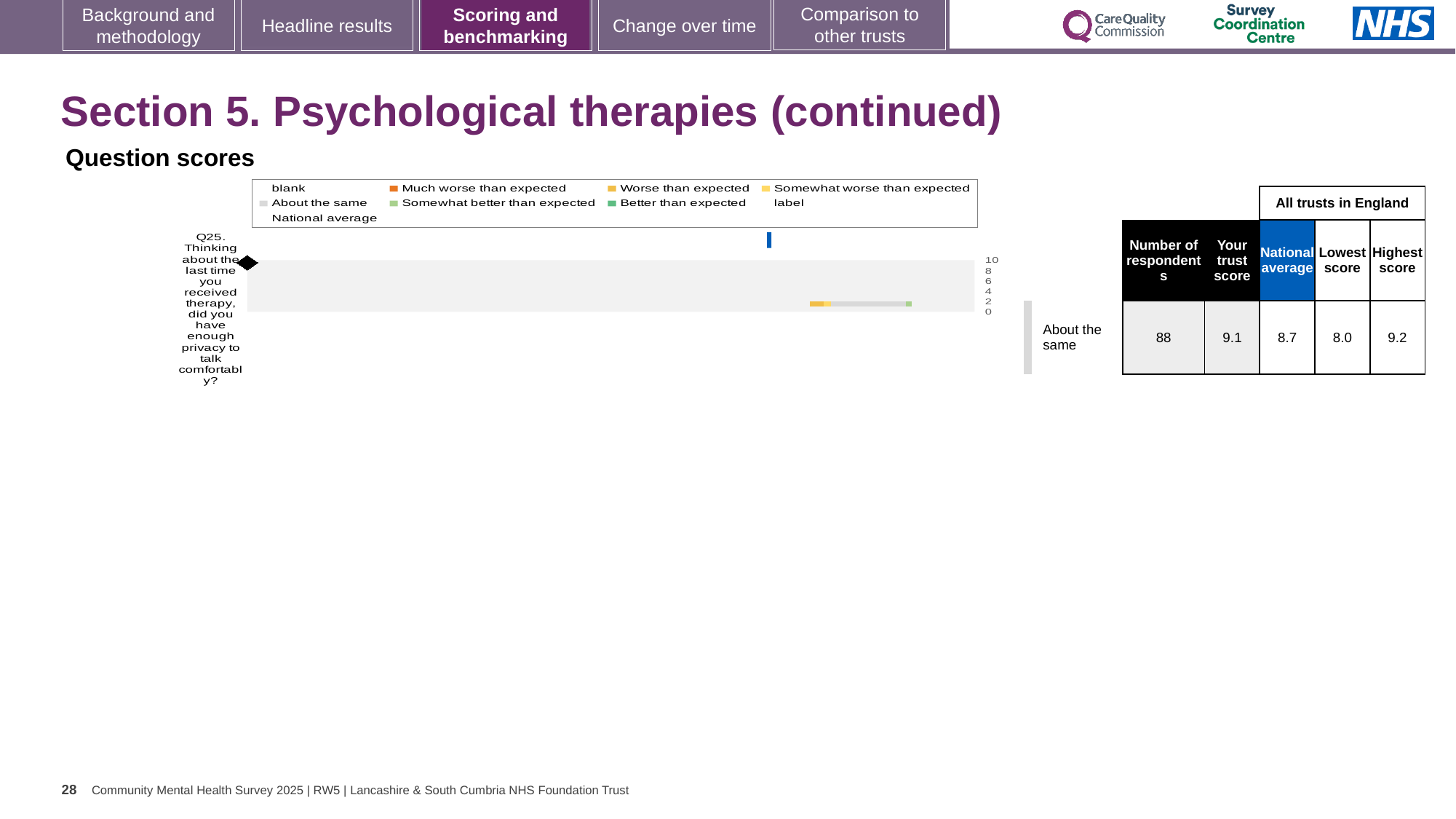
What kind of chart is used to show the Q25 question score? bar chart Which is larger for Q25: the trust's score or the national average? Your trust score What is the highest score among all trusts in England for Q25? 9.2 How many survey questions are plotted on the chart? 1 What is the national average score for Q25? 8.7 By how much does the trust's score for Q25 exceed the national average? 0.4 How is the trust's result for Q25 categorised relative to expectations? About the same What is the difference between the highest and lowest scores for Q25 across all trusts in England? 1.2 What is the trust's score for Q25 (privacy to talk comfortably during therapy)? 9.1 How many respondents answered Q25? 88 What is the lowest score among all trusts in England for Q25? 8.0 What is the maximum value shown on the chart's score axis? 10